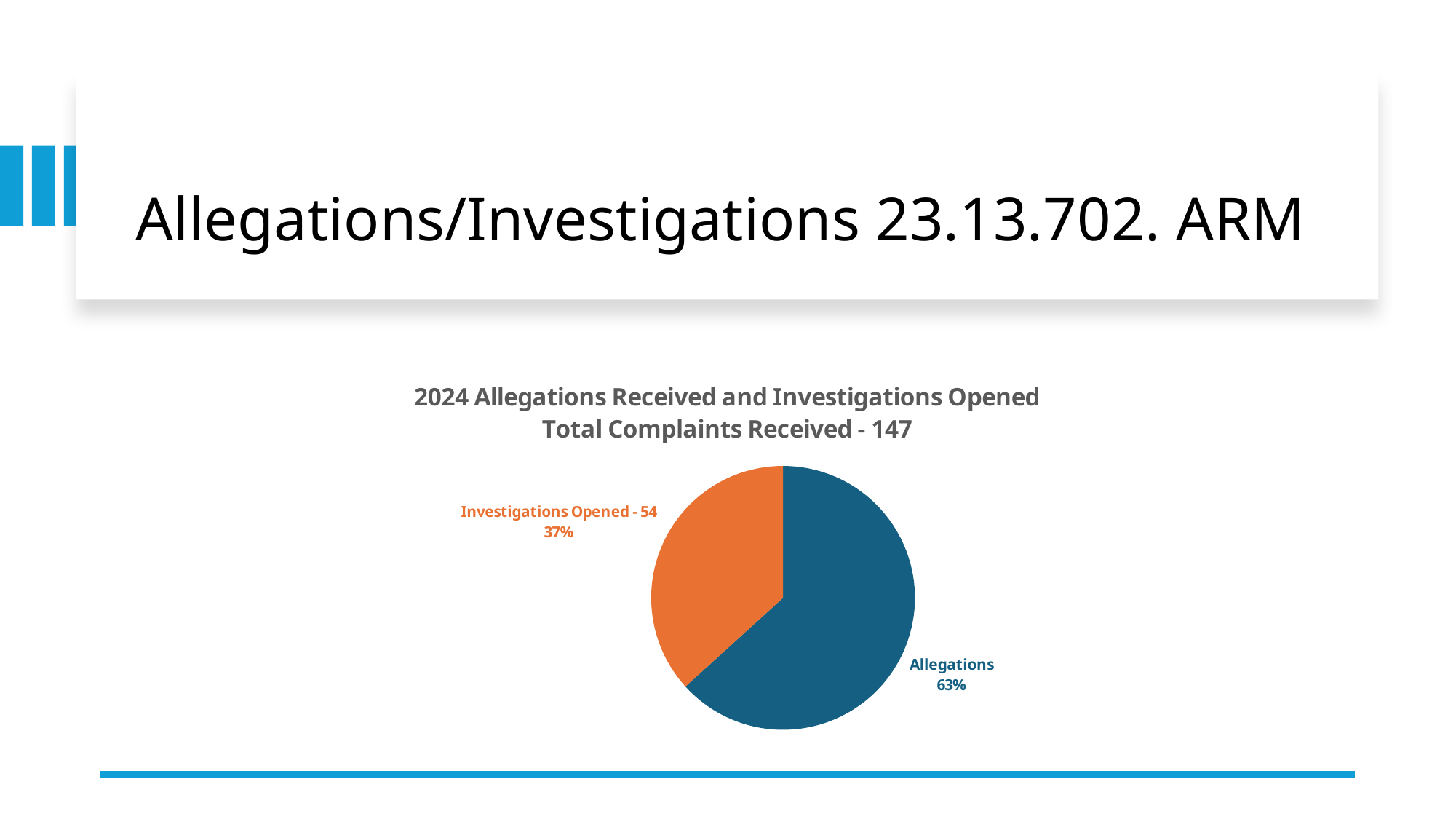
How many slices does the pie chart have? 2 What colour is the Investigations Opened slice? orange What percentage of the pie is the Investigations Opened slice? 37% What is the title of the chart? 2024 Allegations Received and Investigations Opened Total Complaints Received - 147 Which is larger, the Allegations slice or the Investigations Opened slice? Allegations Which slice is the largest in the pie chart? Allegations Which slice is the smallest in the pie chart? Investigations Opened What is the difference in percentage points between the Allegations slice and the Investigations Opened slice? 26 How many investigations were opened according to the chart label? 54 What is the total number of complaints received stated in the chart title? 147 What percentage of the pie is the Allegations slice? 63% What kind of chart is shown on the slide? pie chart